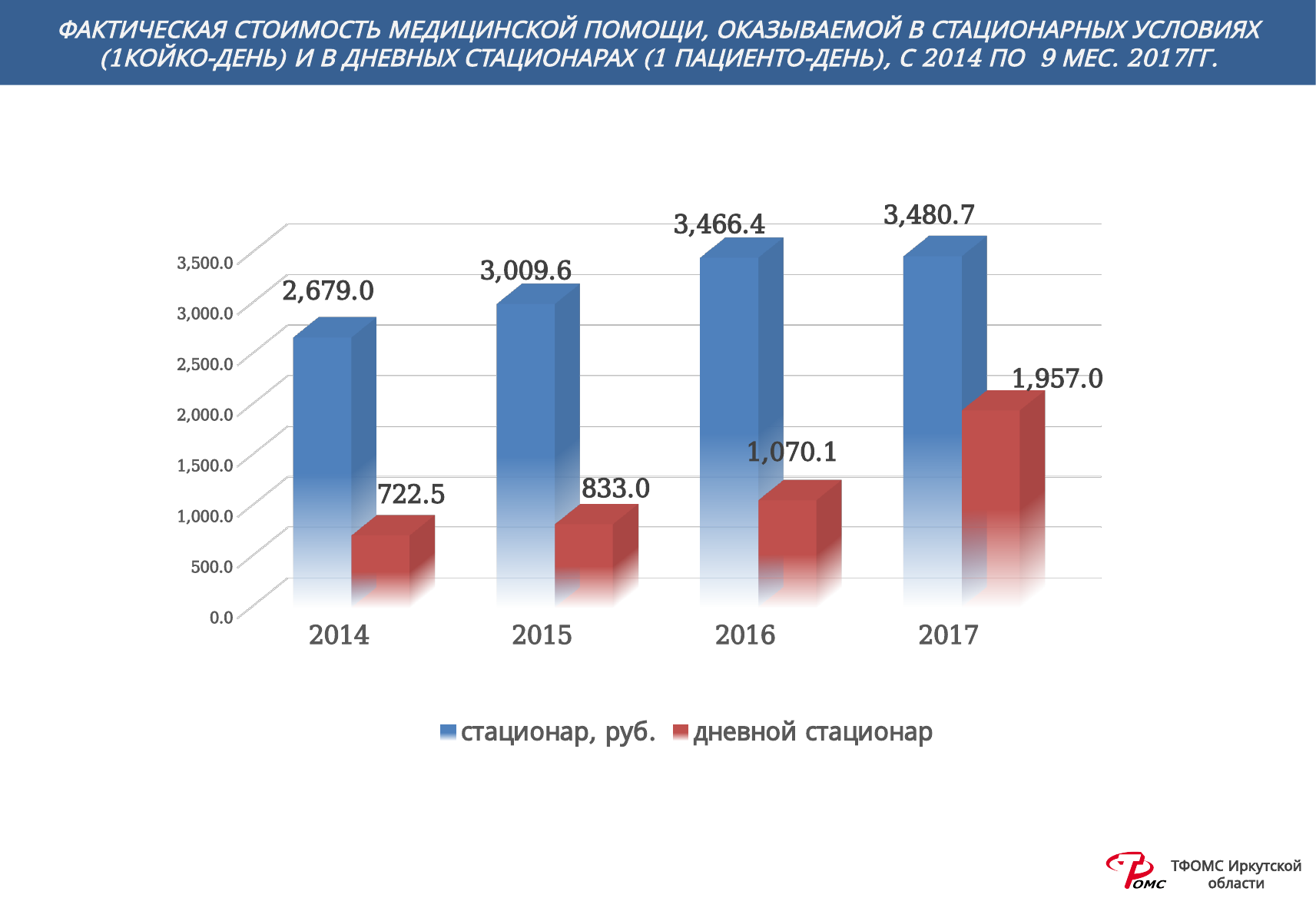
Do the дневной стационар values rise or fall from 2014 to 2017? rise In which year is the стационар, руб. value highest? 2017 What kind of chart is shown on the slide? bar chart In which year is the дневной стационар value lowest? 2014 What is the value for стационар, руб. in 2014? 2,679.0 What is the value for дневной стационар in 2016? 1,070.1 What is the difference between the дневной стационар values for 2017 and 2016? 886.9 How many years are shown on the x axis? 4 How many series does the legend list? 2 Which is larger: дневной стационар in 2015 or дневной стационар in 2014? дневной стационар in 2015 What is the difference between the стационар, руб. values for 2016 and 2015? 456.8 What is the value for дневной стационар in 2017? 1,957.0